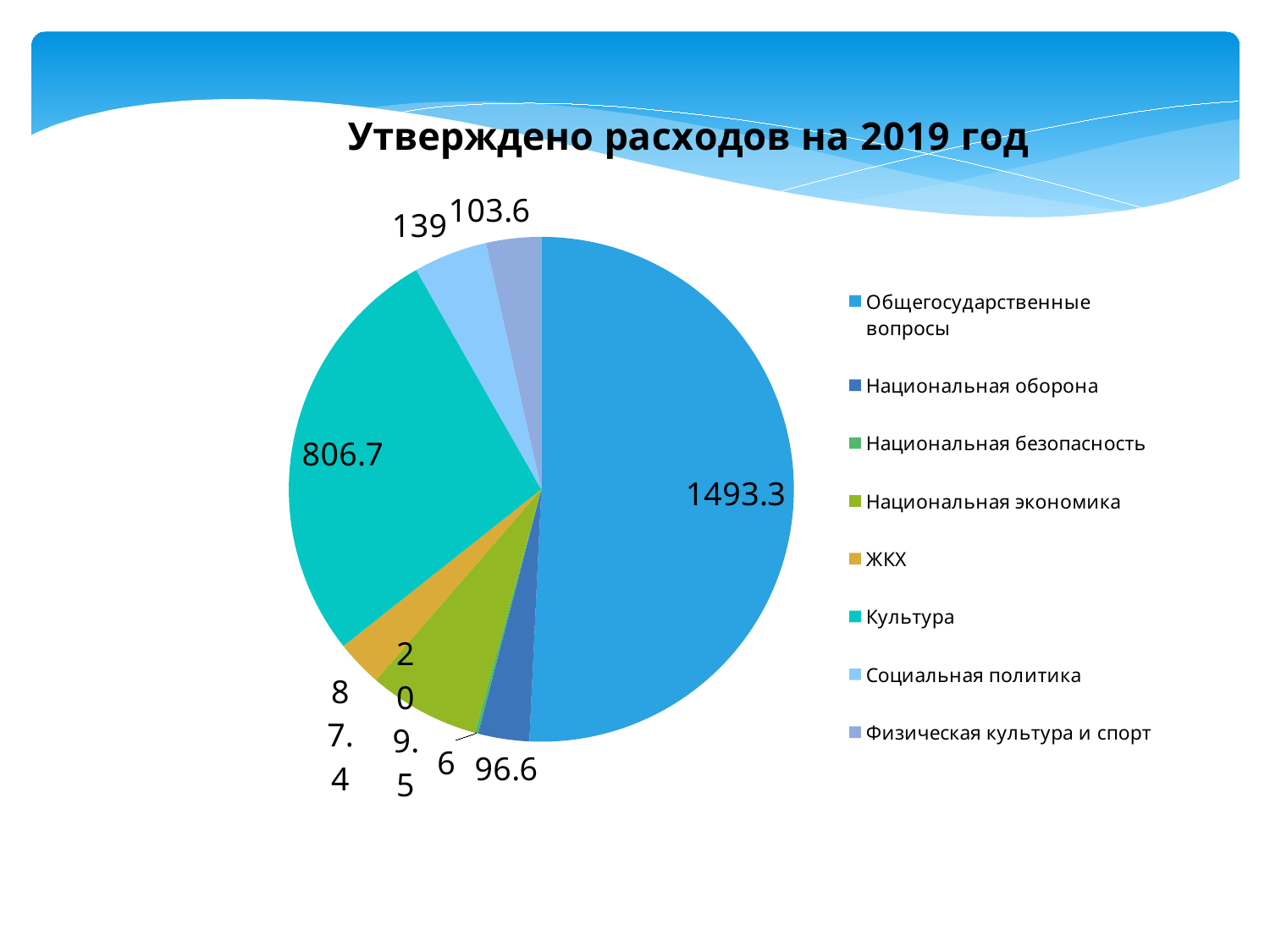
How many categories does the legend list? 8 What is the difference between the values for Общегосударственные вопросы and Культура? 686.6 What is the value for Общегосударственные вопросы? 1493.3 What is the value for Культура? 806.7 What is the difference between the values for Физическая культура и спорт and Национальная оборона? 7 What is the value for Национальная оборона? 96.6 What kind of chart is shown on the slide? pie chart Which category has the largest slice? Общегосударственные вопросы What is the value for Социальная политика? 139 Which is larger, the value for Национальная экономика or the value for Социальная политика? Национальная экономика What is the title of the chart? Утверждено расходов на 2019 год Which category has the smallest slice? Национальная безопасность